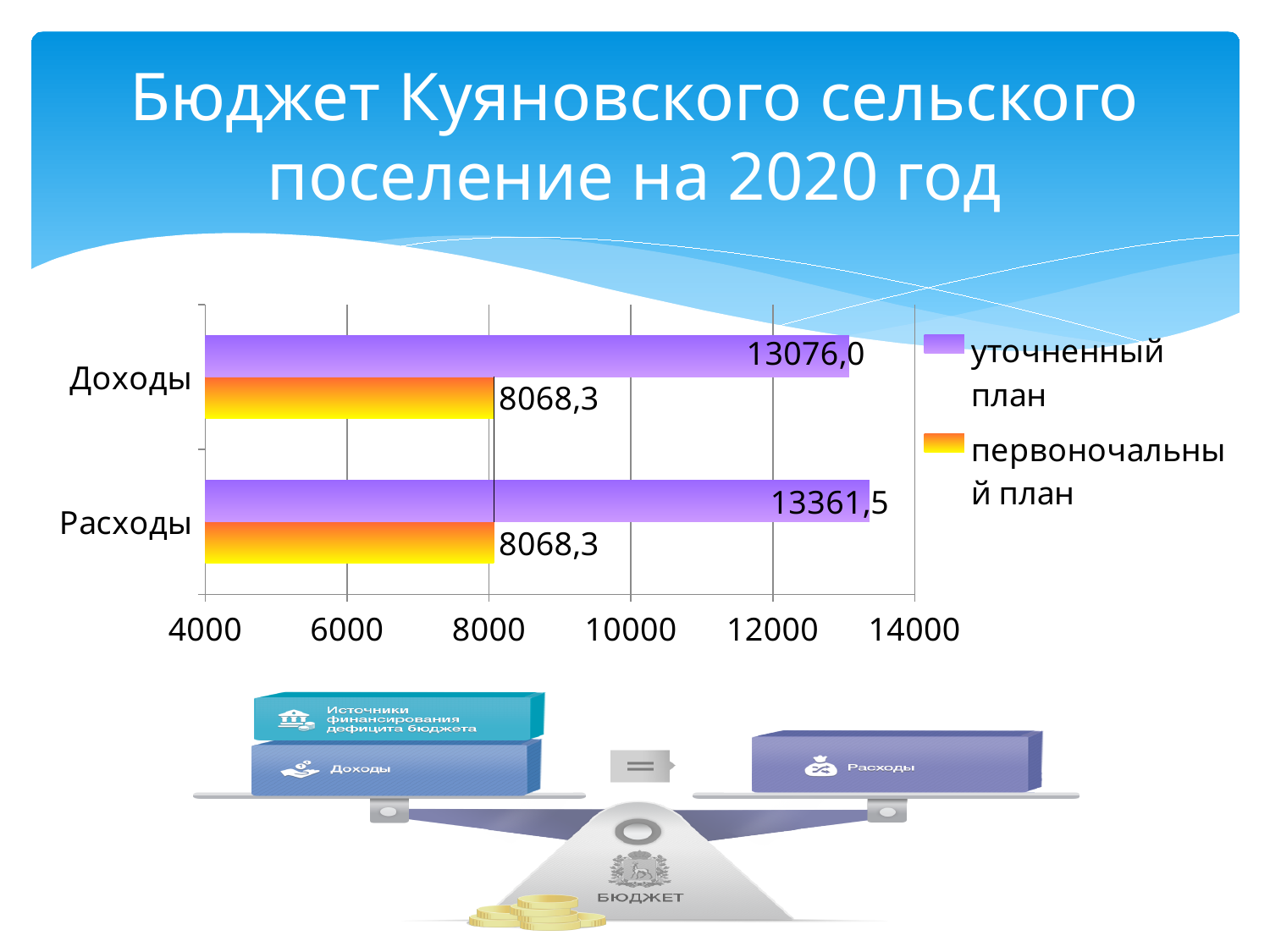
What is the первоночальный план value for Расходы? 8068,3 Which series is shown in purple in the legend? уточненный план What kind of chart is shown on the slide? bar chart Which category has the higher уточненный план value, Доходы or Расходы? Расходы For Расходы, what is the difference between the уточненный план and the первоночальный план? 5293,2 How many series does the legend list? 2 Is the уточненный план value for Доходы greater or less than 12000? greater What is the уточненный план value for Расходы? 13361,5 How many categories are shown on the chart? 2 For Доходы, what is the difference between the уточненный план and the первоночальный план? 5007,7 What is the difference between the уточненный план values for Расходы and Доходы? 285,5 What is the уточненный план value for Доходы? 13076,0